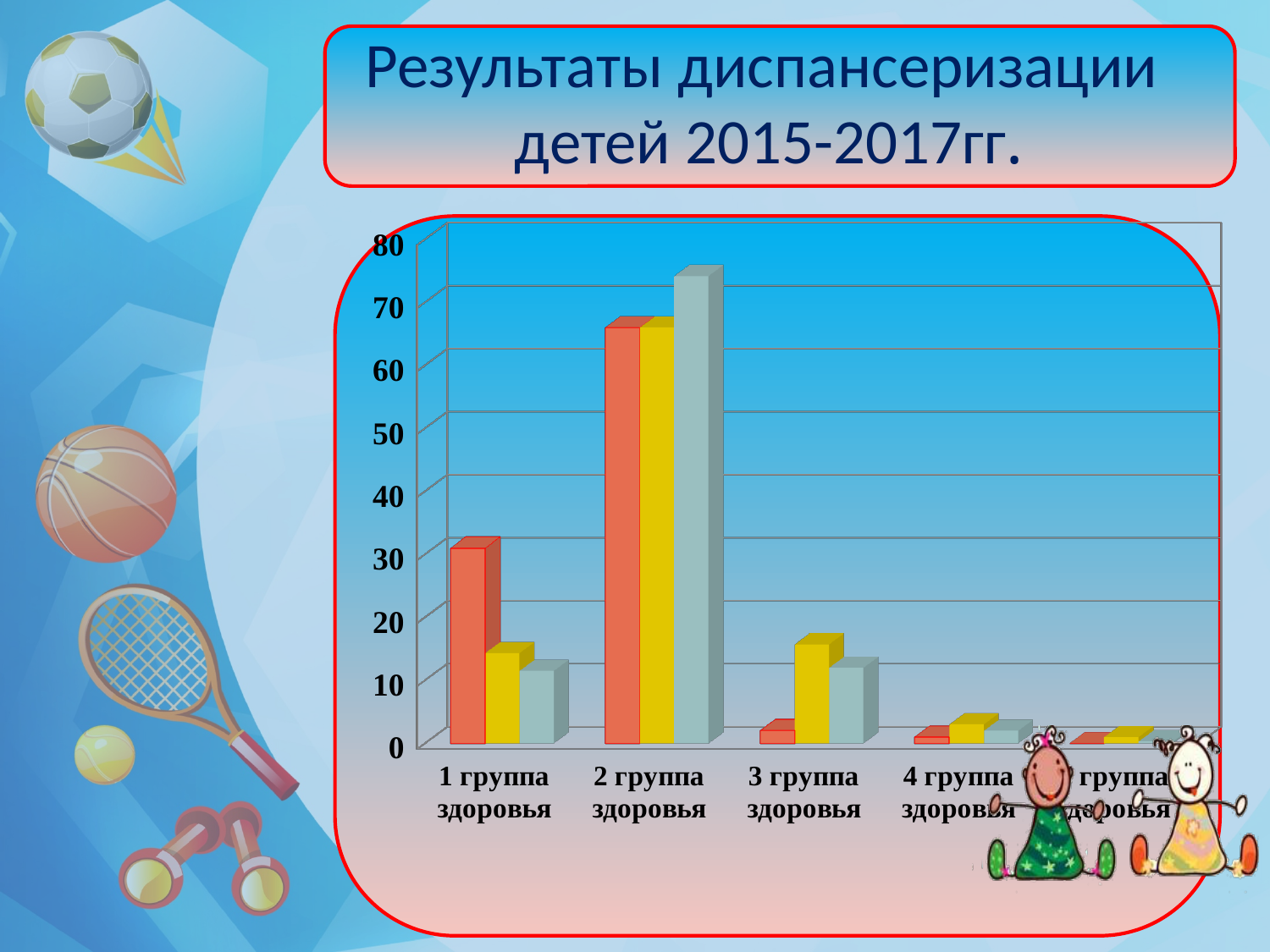
Which health group has the highest bars in the chart? 2 группа здоровья How many categories (health groups) are shown on the x axis of the chart? 5 For 1 группа здоровья, which bar is larger: the red bar or the yellow bar? the red bar Is the value of the red bar for 1 группа здоровья greater or less than 20? greater Is the value of the light blue bar for 2 группа здоровья greater or less than 70? greater Is the value of the red bar for 3 группа здоровья greater or less than 10? less How many bars are plotted for each health group in the chart? 3 For 3 группа здоровья, which bar is larger: the red bar or the yellow bar? the yellow bar What is the title of the slide containing the chart? Результаты диспансеризации детей 2015-2017гг. What kind of chart is shown on the slide? bar chart